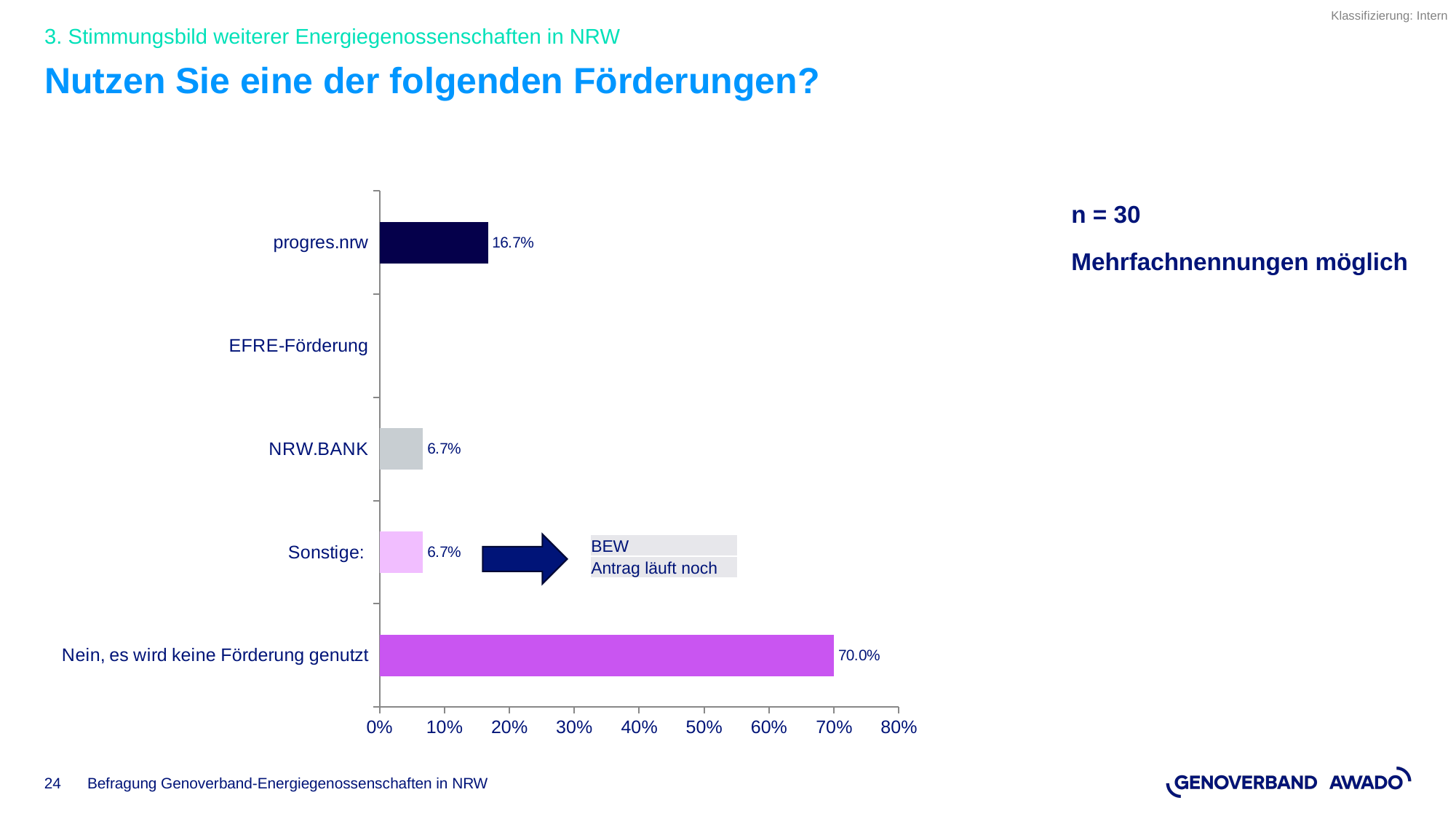
What is the highest value shown on the x axis? 80% Is the value for "Nein, es wird keine Förderung genutzt" greater or less than 60%? greater Which is larger, the value for progres.nrw or the value for Sonstige? progres.nrw What is the value for "Nein, es wird keine Förderung genutzt"? 70.0% What is the value for progres.nrw? 16.7% What is the difference between the values for progres.nrw and NRW.BANK? 10.0% What is the sample size (n) stated on the slide? n = 30 What is the difference between the values for "Nein, es wird keine Förderung genutzt" and progres.nrw? 53.3% How many categories are shown on the chart? 5 What kind of chart is shown on the slide? bar chart Which category has the highest value? Nein, es wird keine Förderung genutzt What is the value for NRW.BANK? 6.7%